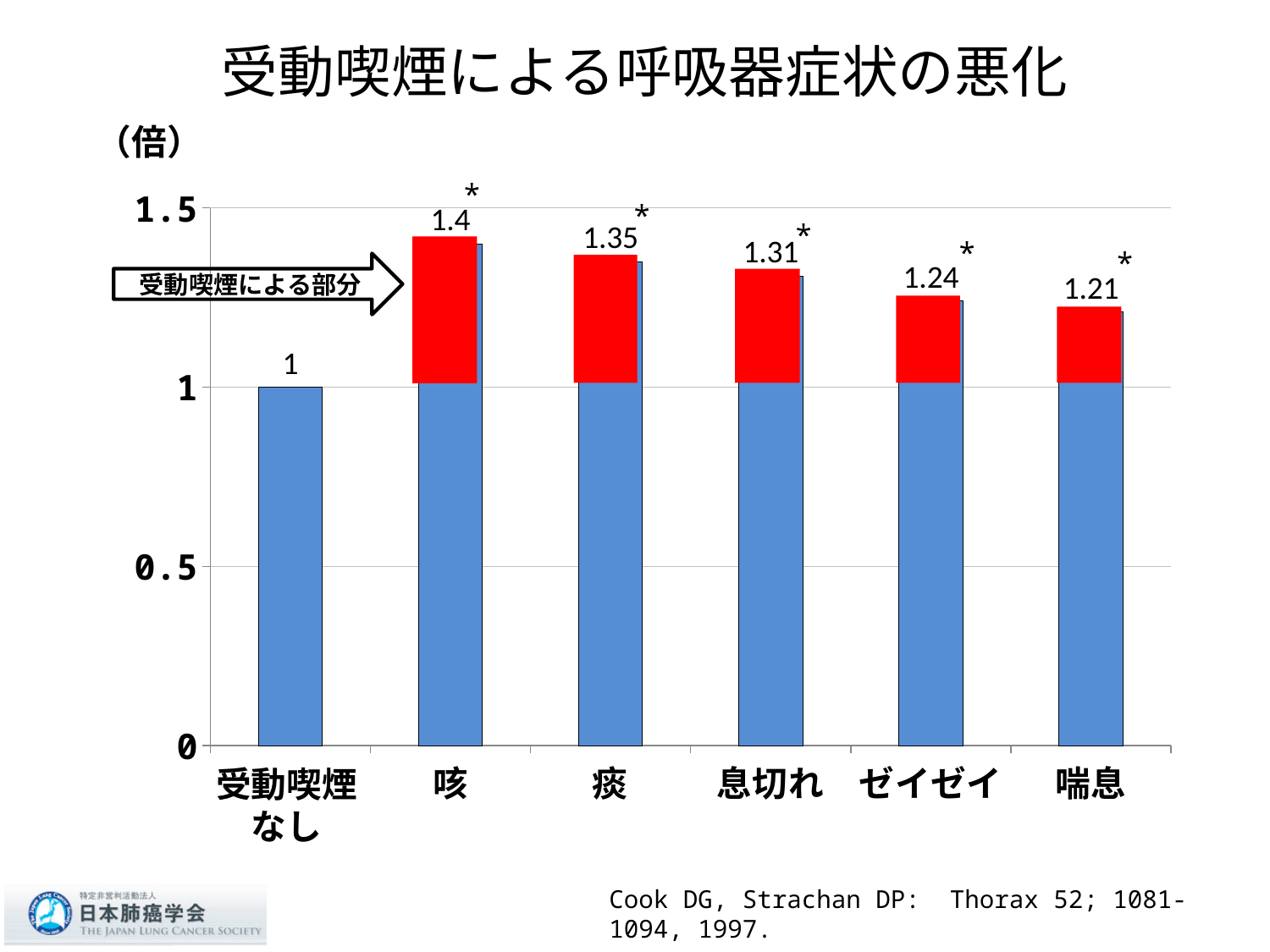
Which category has the lowest value? 受動喫煙なし What is the value shown for ゼイゼイ? 1.24 Which is larger, the value for 痰 or the value for ゼイゼイ? 痰 What is the difference between the values for 咳 and 喘息? 0.19 Which category has the highest value? 咳 What is the title of the chart? 受動喫煙による呼吸器症状の悪化 How many categories are shown on the x axis? 6 What is the value shown for 喘息? 1.21 What is the value shown for 息切れ? 1.31 What is the value shown for 痰? 1.35 What is the value shown for 咳? 1.4 What kind of chart is shown on the slide? Bar chart